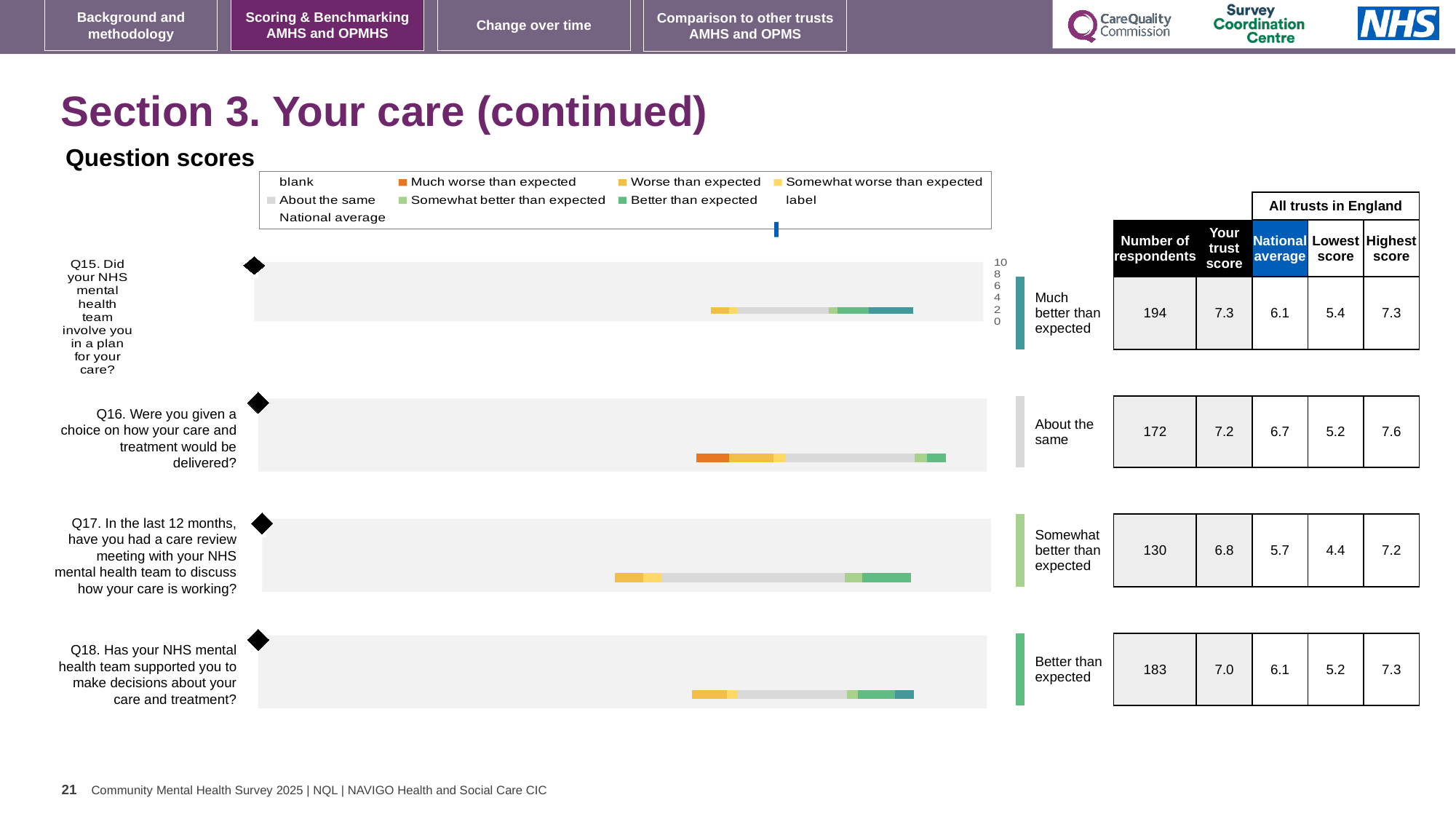
What is the trust score for Q16 (Were you given a choice on how your care and treatment would be delivered?)? 7.2 What is the highest score among all trusts in England for Q18 (supported you to make decisions about your care and treatment)? 7.3 What is the number of respondents for Q15 (Did your NHS mental health team involve you in a plan for your care?)? 194 For Q16, which is larger: the trust score or the national average? the trust score What kind of chart is used to show the question scores on this slide? bar chart How many survey questions (rows) are plotted in the question scores chart? 4 What is the national average for Q17 (care review meeting in the last 12 months)? 5.7 What is the difference between the trust score and the national average for Q15? 1.2 Which question has the highest number of respondents? Q15 Which question has the lowest trust score? Q17 What is the heading shown above the chart? Question scores What is the lowest score among all trusts in England for Q17? 4.4